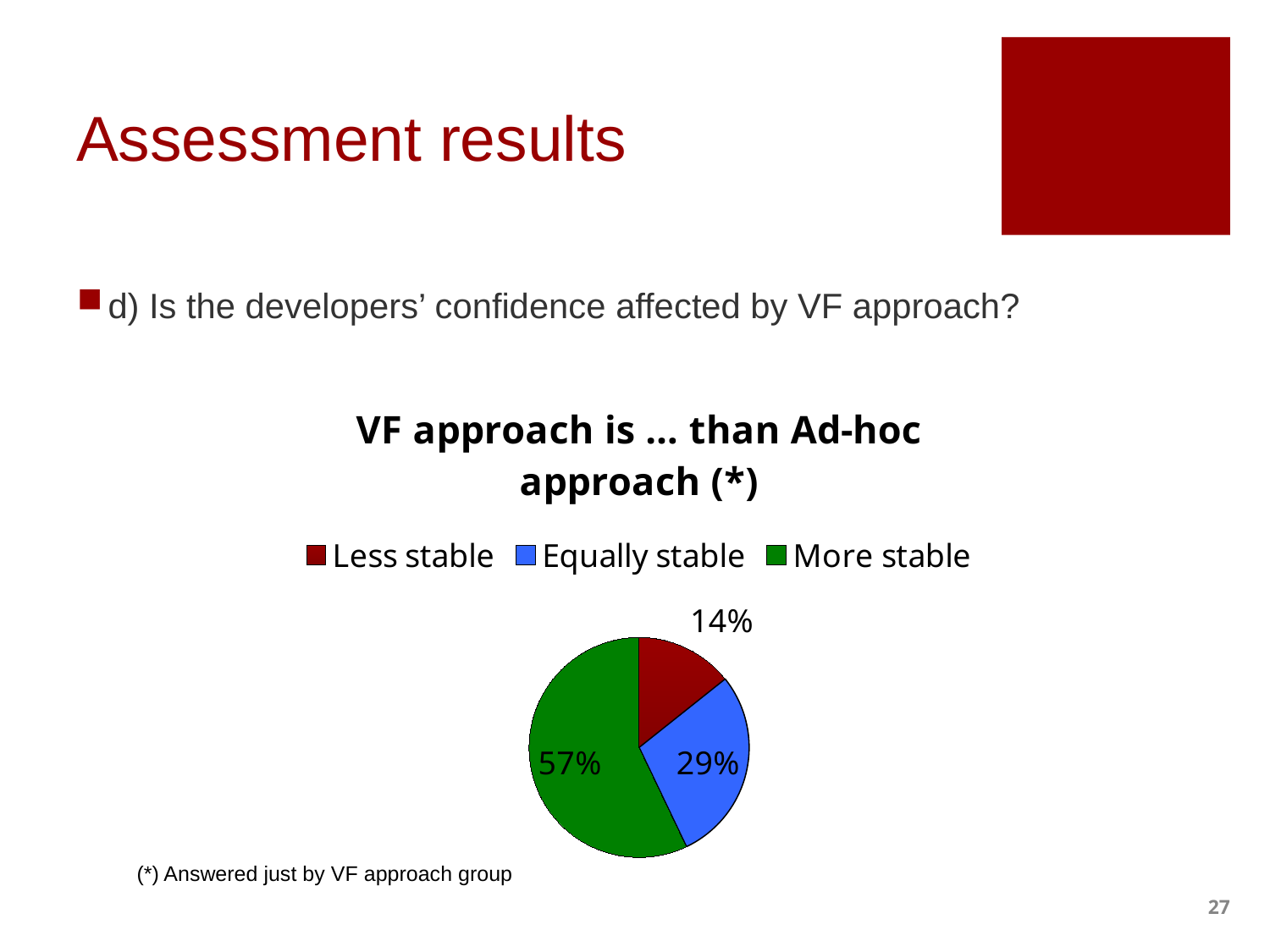
What share of the pie is labelled "More stable"? 57% What share of the pie is labelled "Less stable"? 14% What is the difference in percentage points between the "More stable" and "Equally stable" slices? 28 What is the title of the pie chart? VF approach is … than Ad-hoc approach (*) Which category has the largest slice of the pie? More stable What share of the pie is labelled "Equally stable"? 29% What colour is the "Equally stable" slice? blue Which category has the smallest slice of the pie? Less stable What kind of chart is shown on the slide? pie chart Which slice is larger, "Equally stable" or "Less stable"? Equally stable How many categories does the pie chart show? 3 How many entries does the legend list? 3